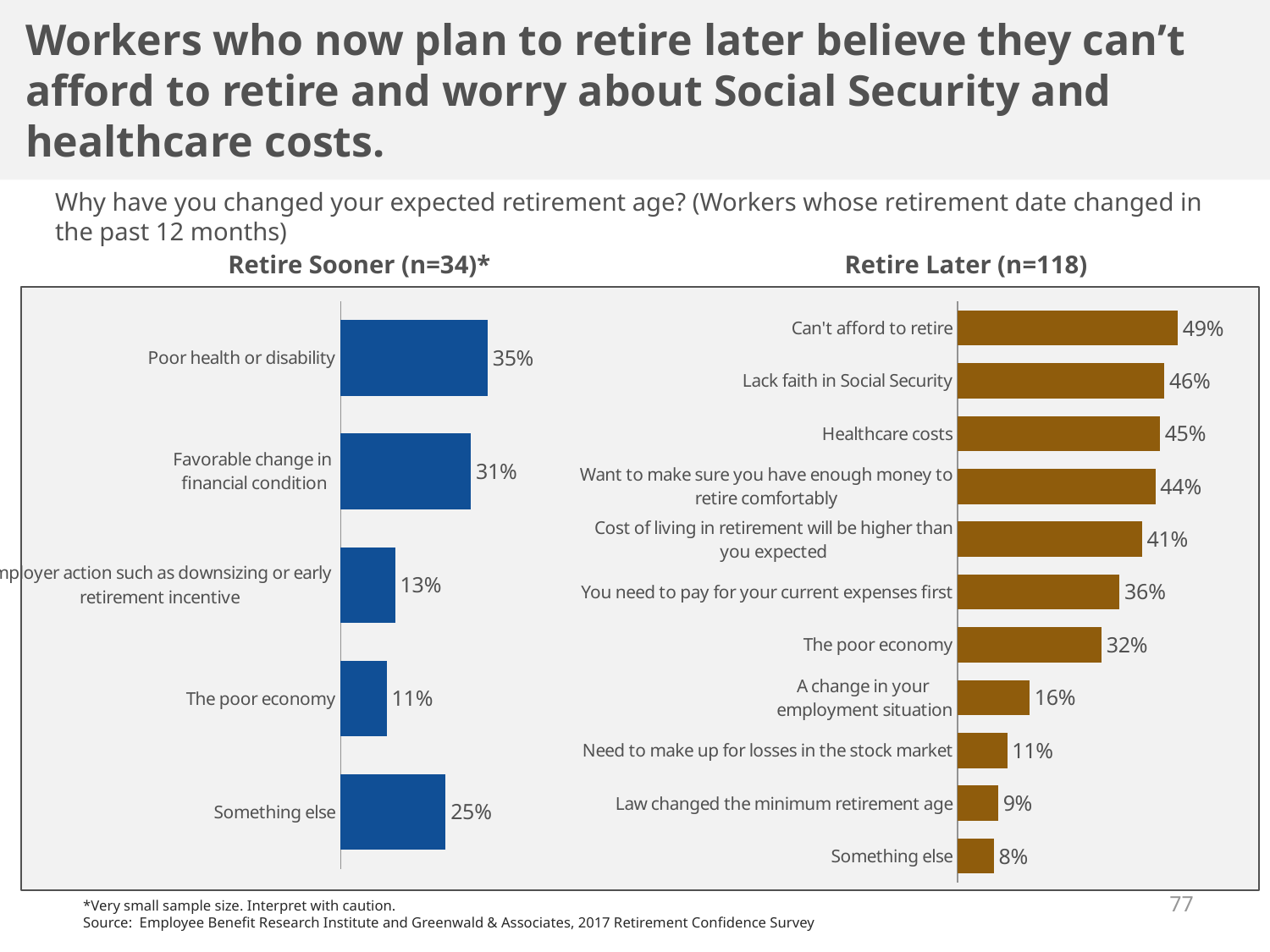
In the Retire Sooner (n=34)* chart, what percentage is shown for "Poor health or disability"? 35% In the Retire Sooner (n=34)* chart, which category has the lowest value? The poor economy What type of chart is the Retire Later (n=118) chart? Bar chart In the Retire Later (n=118) chart, what percentage is shown for "Can't afford to retire"? 49% How many categories are shown in the Retire Later (n=118) chart? 11 Which is larger: "The poor economy" in the Retire Sooner (n=34)* chart or "The poor economy" in the Retire Later (n=118) chart? Retire Later (n=118) In the Retire Sooner (n=34)* chart, which category has the highest value? Poor health or disability In the Retire Later (n=118) chart, what is the difference between "Lack faith in Social Security" and "The poor economy"? 14 percentage points In the Retire Later (n=118) chart, what percentage is shown for "Healthcare costs"? 45% In the Retire Later (n=118) chart, which category has the lowest value? Something else In the Retire Sooner (n=34)* chart, what is the difference between "Poor health or disability" and "Something else"? 10 percentage points How many categories are shown in the Retire Sooner (n=34)* chart? 5